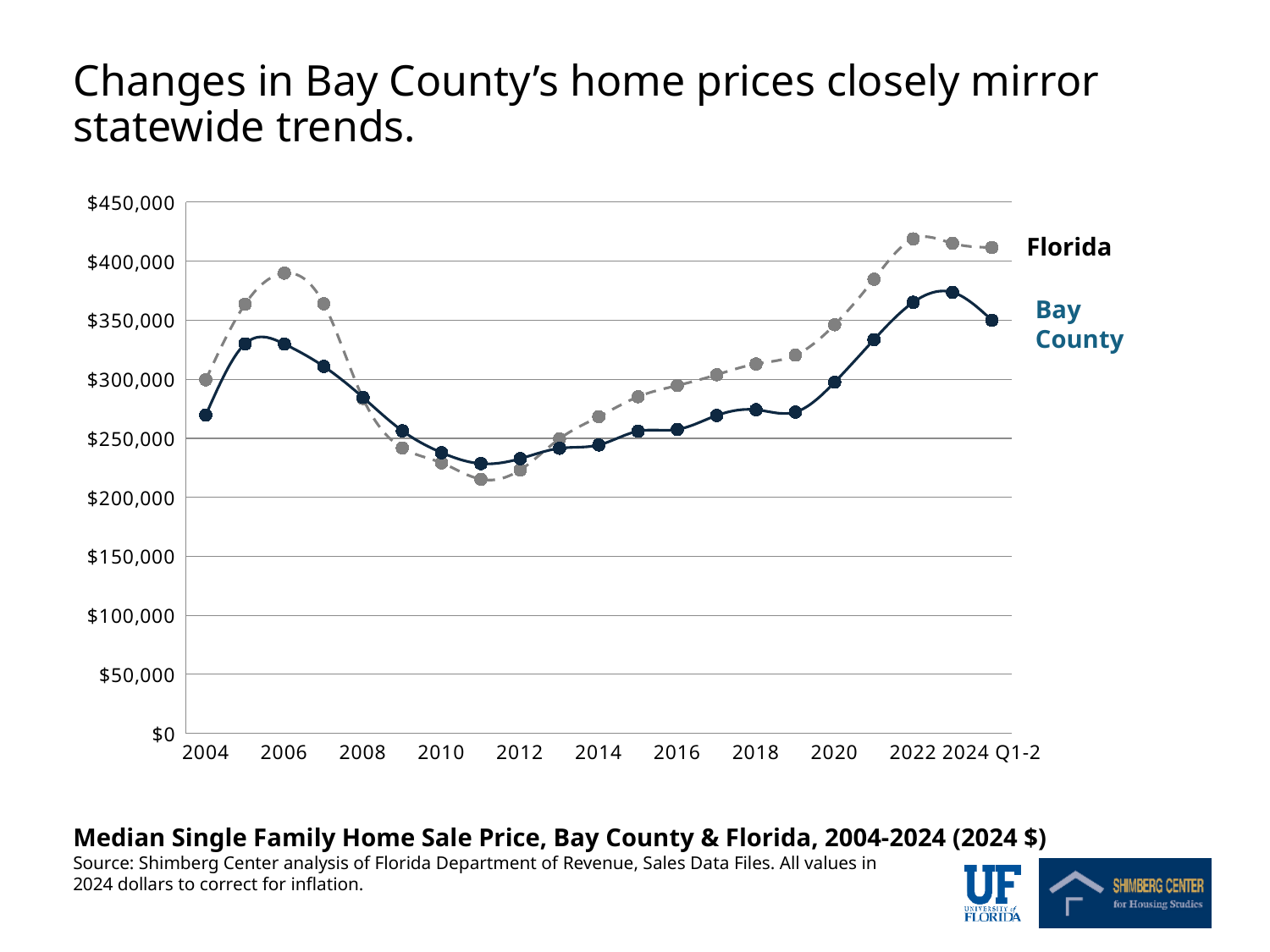
Which series is drawn with a dashed gray line? Florida In which year does the Florida series reach its lowest value? 2011 In 2006, which series has the higher value, Florida or Bay County? Florida Is the Bay County value for 2011 greater or less than $250,000? less How many series does the chart show? 2 What is the title of the chart? Median Single Family Home Sale Price, Bay County & Florida, 2004-2024 (2024 $) Is the Florida value for 2006 greater or less than $350,000? greater Is the Florida value for 2022 greater or less than $400,000? greater In 2009, which series has the higher value, Florida or Bay County? Bay County What kind of chart is shown on the slide? line chart Do Bay County values rise or fall from 2006 to 2011? fall